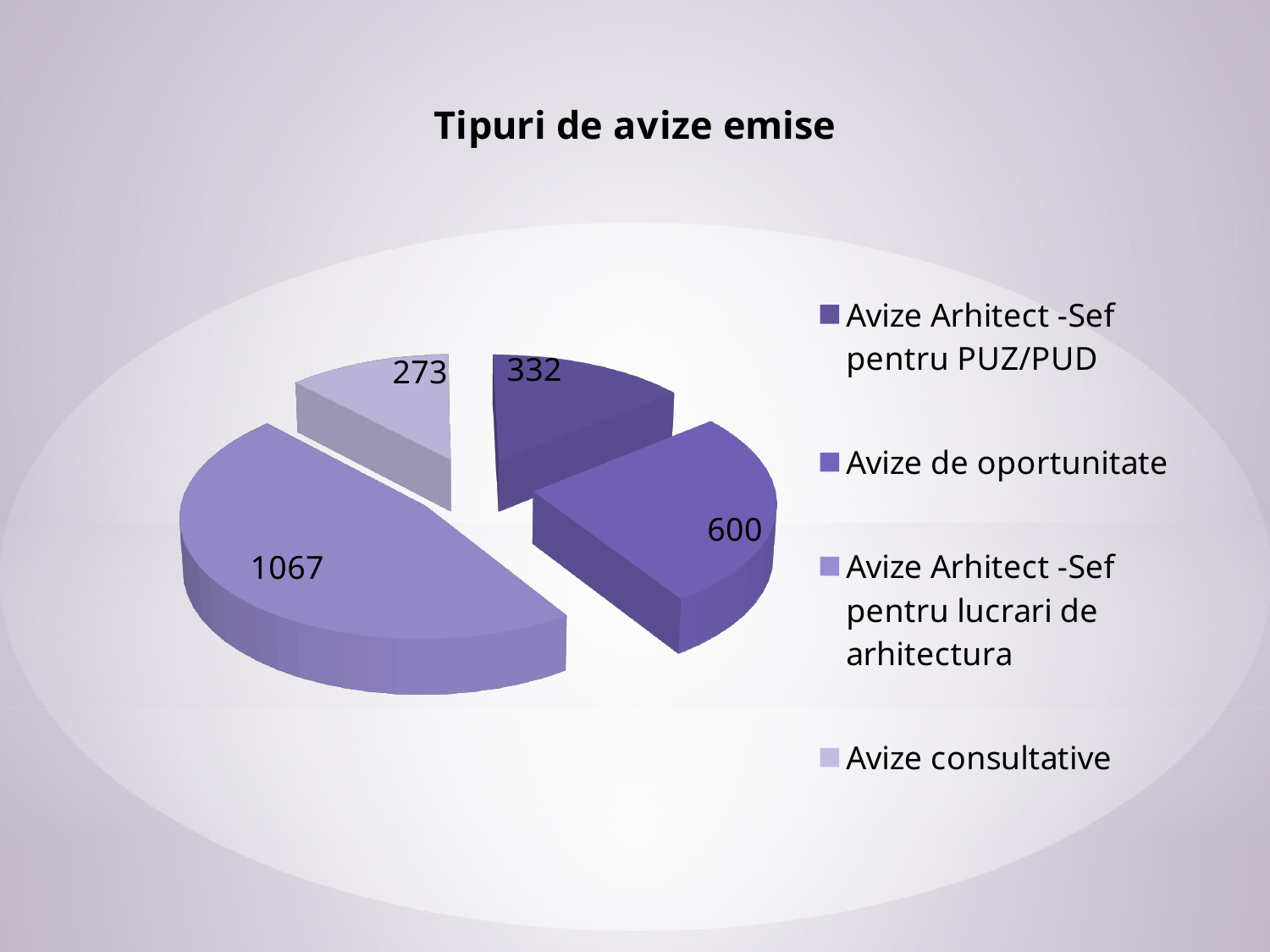
How many entries does the legend list? 4 What is the value for Avize consultative? 273 Which category has the largest slice? Avize Arhitect-Sef pentru lucrari de arhitectura What is the title of the chart? Tipuri de avize emise What is the value for Avize de oportunitate? 600 What is the total of all four slices? 2272 What is the difference between the values for Avize Arhitect-Sef pentru lucrari de arhitectura and Avize de oportunitate? 467 What is the value for Avize Arhitect-Sef pentru PUZ/PUD? 332 What type of chart is shown on the slide? Pie chart Which is larger, Avize Arhitect-Sef pentru PUZ/PUD or Avize consultative? Avize Arhitect-Sef pentru PUZ/PUD Which category has the smallest slice? Avize consultative How many slices does the pie chart have? 4